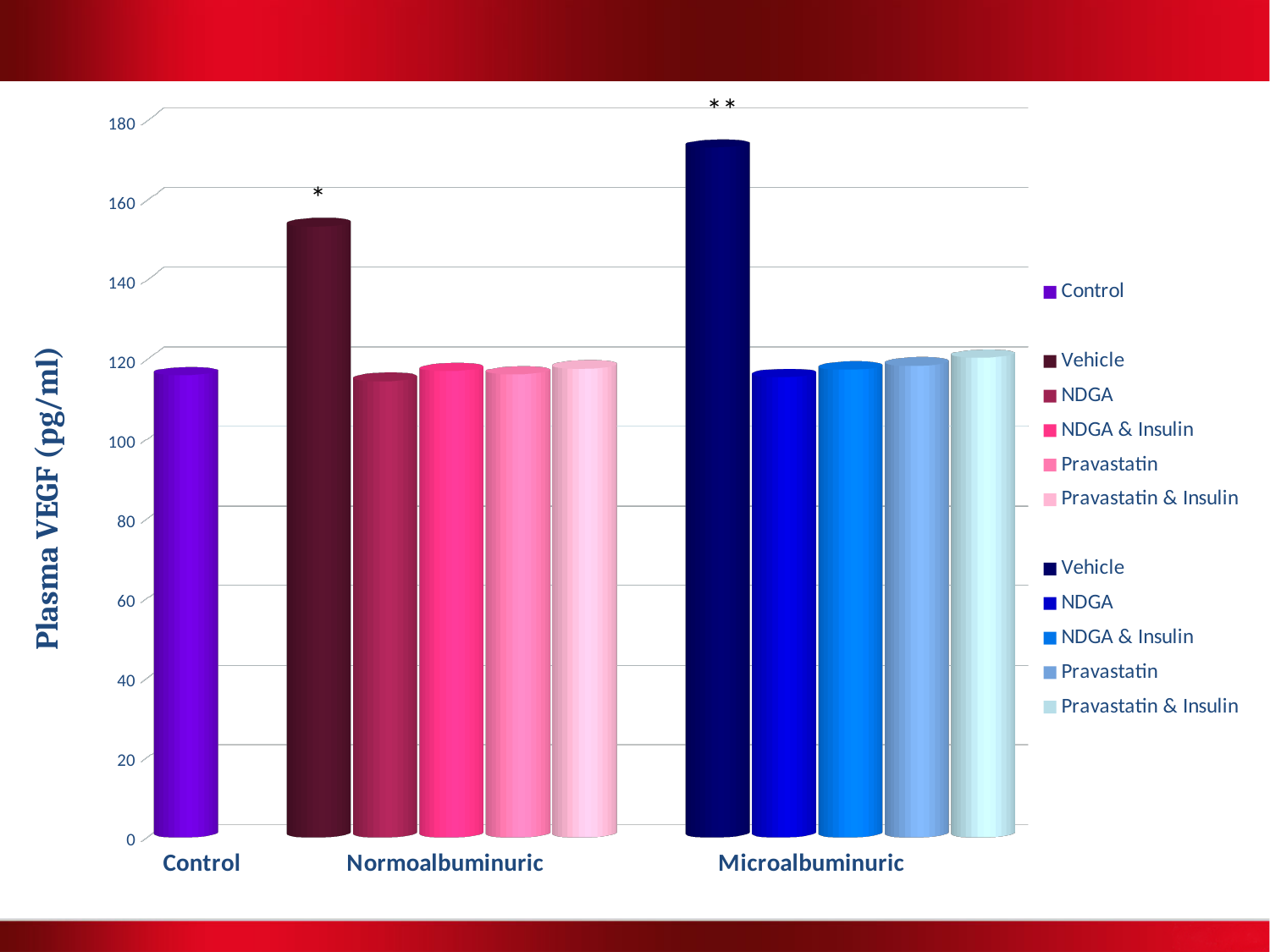
Is the value for Vehicle in the Normoalbuminuric group greater or less than 140? greater Which is larger, the Vehicle bar in the Normoalbuminuric group or the Vehicle bar in the Microalbuminuric group? Vehicle in the Microalbuminuric group Is the value for NDGA in the Normoalbuminuric group greater or less than 100? greater What kind of chart is shown on the slide? bar chart Which is larger, the Vehicle bar in the Normoalbuminuric group or the Control bar? Vehicle in the Normoalbuminuric group What is the title of the y axis? Plasma VEGF (pg/ml) How many categories are shown along the x axis? 3 Is the value for Vehicle in the Microalbuminuric group greater or less than 160? greater Which x-axis category has only one bar? Control Which bar is the tallest in the chart? Vehicle in the Microalbuminuric group How many series does the legend list? 11